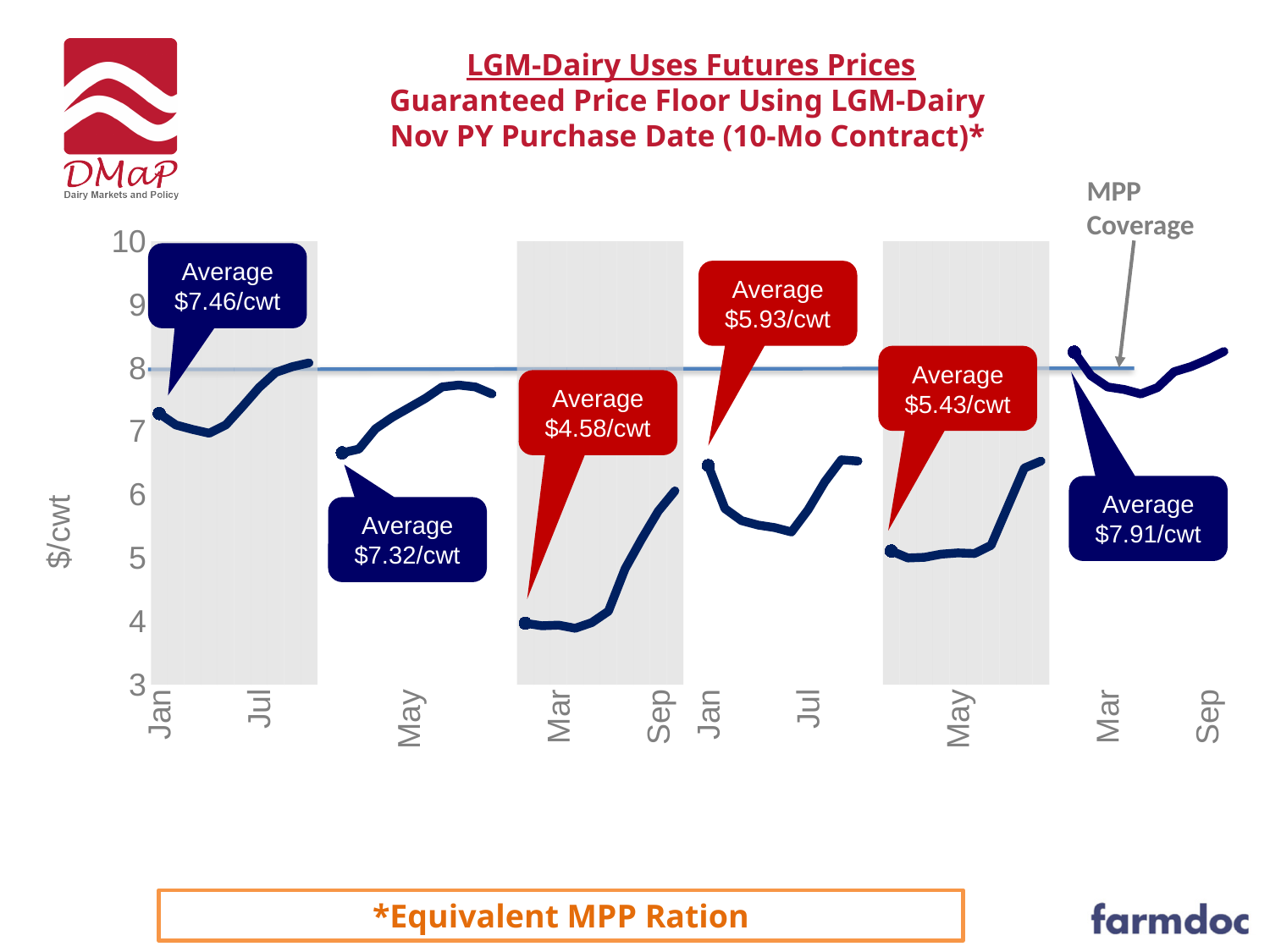
What is the average price shown for the second contract period? $7.32/cwt What is the difference between the highest average ($7.91/cwt) and the lowest average ($4.58/cwt)? $3.33/cwt What is the average price shown for the fourth contract period (the one starting at Jan)? $5.93/cwt What is the average price shown for the first (leftmost) contract period? $7.46/cwt What is the label on the vertical axis of the chart? $/cwt What is the average price shown for the fifth contract period? $5.43/cwt Which contract period has the lowest average price? The third period, $4.58/cwt How many contract periods with an average price callout are shown on the chart? 6 What is the average price shown for the third contract period (the one starting around Mar)? $4.58/cwt Which contract period has the highest average price? The last (rightmost) period, $7.91/cwt What is the average price shown for the last (rightmost) contract period? $7.91/cwt Which is larger, the average for the fourth period ($5.93/cwt) or the fifth period ($5.43/cwt)? $5.93/cwt (fourth period)